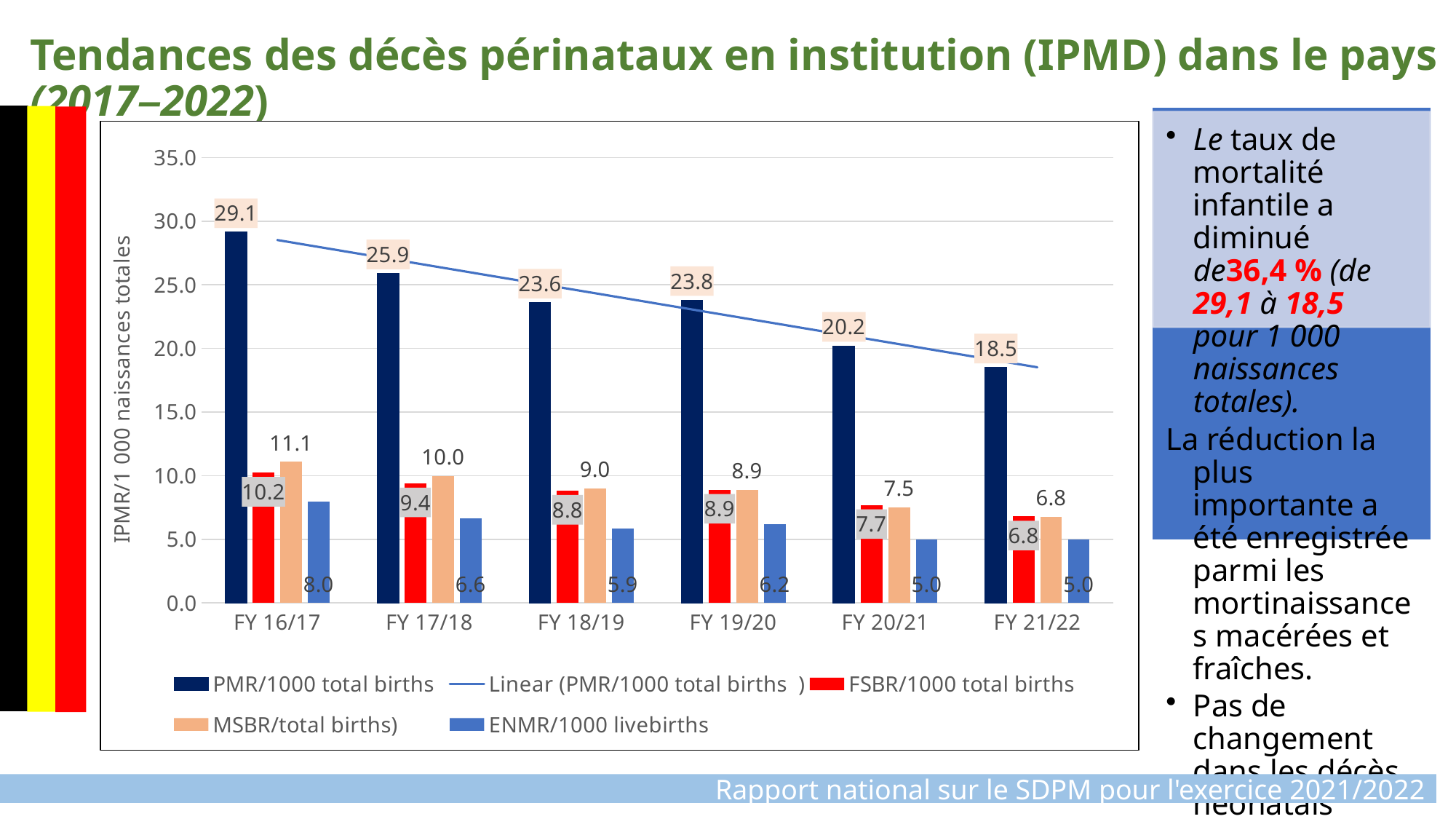
What is the MSBR/total births value for FY 17/18? 10.0 Which is larger, the PMR/1000 total births value for FY 18/19 or for FY 20/21? FY 18/19 What kind of chart is shown on the slide? Bar chart What is the ENMR/1000 livebirths value for FY 19/20? 6.2 How many fiscal years are shown on the x axis? 6 In which fiscal year is the PMR/1000 total births value highest? FY 16/17 In which fiscal year is the PMR/1000 total births value lowest? FY 21/22 What is the PMR/1000 total births value for FY 16/17? 29.1 What is the PMR/1000 total births value for FY 21/22? 18.5 Does the PMR/1000 total births value generally rise or fall from FY 16/17 to FY 21/22? Fall What is the difference between the PMR/1000 total births values for FY 16/17 and FY 21/22? 10.6 How many entries does the legend list? 5